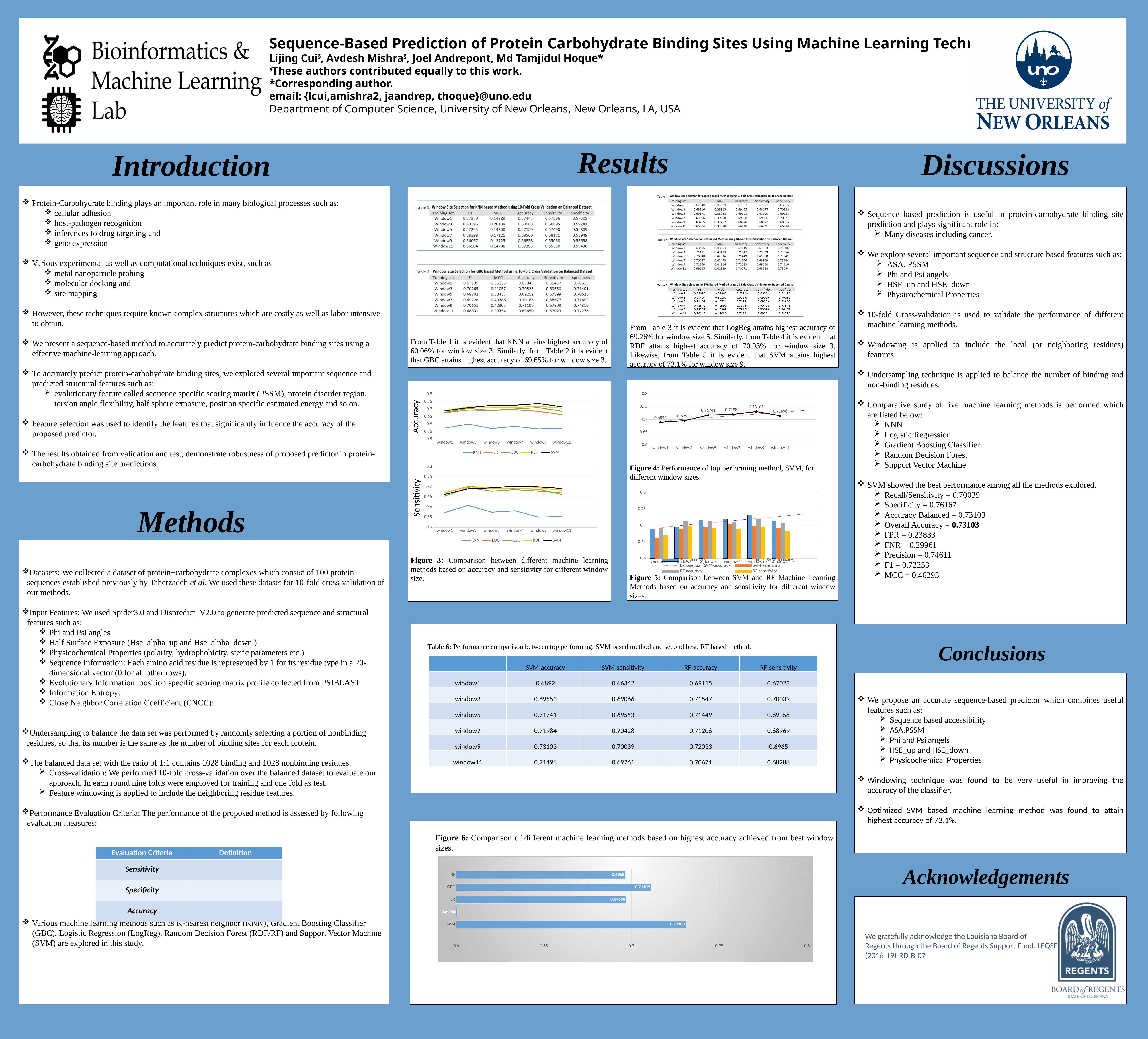
In Figure 4 (performance of SVM for different window sizes), how many window sizes are plotted? 6 In the Accuracy line chart of Figure 3, how many methods does the legend list? 5 In Figure 4 (performance of SVM for different window sizes), what is the value plotted for window1? 0.6892 In Figure 6 (comparison of machine learning methods by highest accuracy), which method has the lowest accuracy? KNN In Figure 6 (comparison of machine learning methods by highest accuracy), what kind of chart is shown? Bar chart In Figure 4 (performance of SVM for different window sizes), what is the difference between the values for window9 and window1? 0.04183 In Figure 4 (performance of SVM for different window sizes), which window size has the highest value? window9 In Figure 6 (comparison of machine learning methods by highest accuracy), what is the accuracy shown for GBC? 0.71109 In Figure 6 (comparison of machine learning methods by highest accuracy), which method has the highest accuracy? SVM In Figure 4 (performance of SVM for different window sizes), what is the value plotted for window9? 0.73103 In Figure 6 (comparison of machine learning methods by highest accuracy), is the value for KNN greater or less than 0.65? less In Figure 4 (performance of SVM for different window sizes), which window size has the lowest value? window1